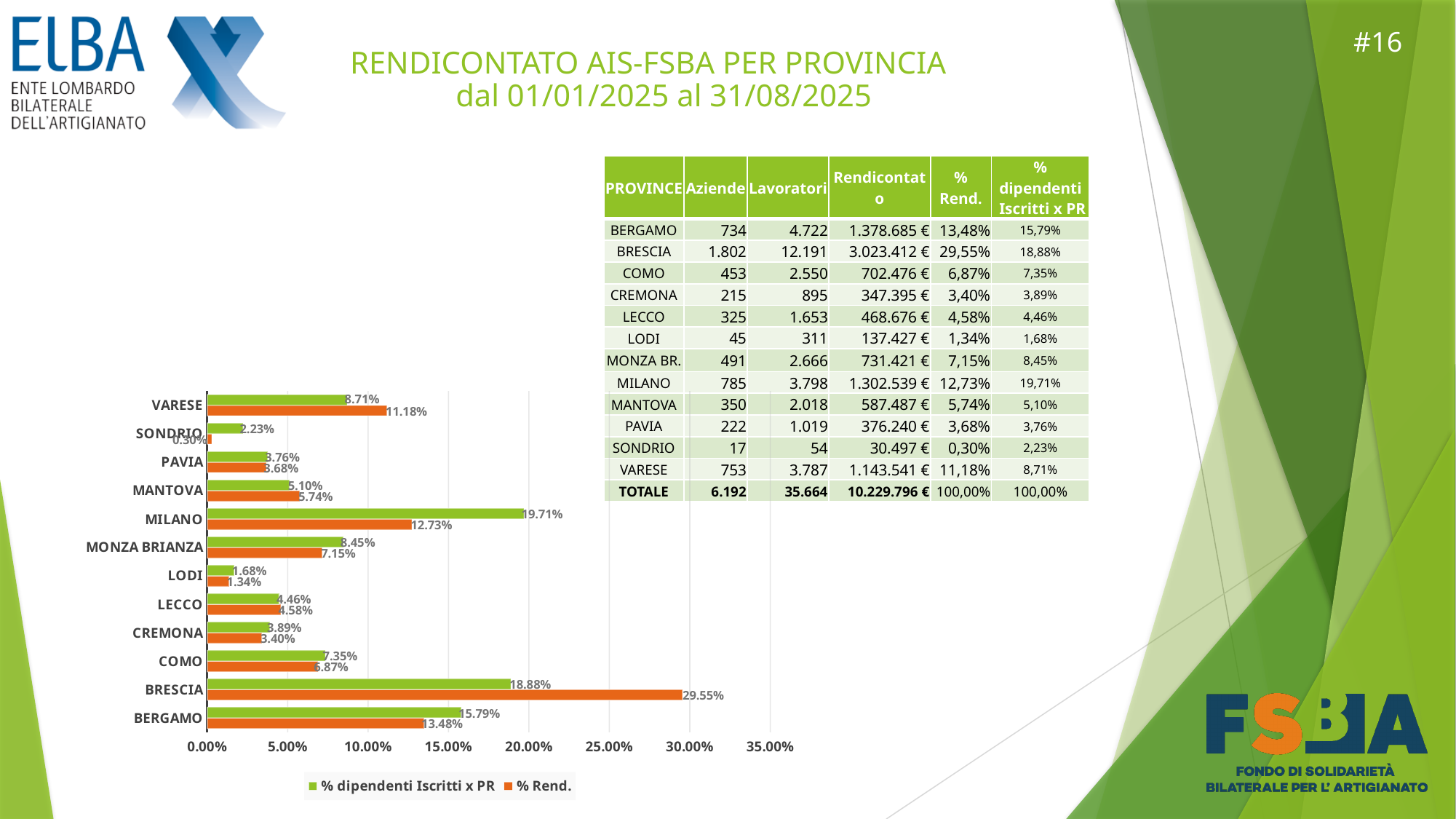
What is the difference between the % Rend. and the % dipendenti Iscritti x PR values for BRESCIA? 10.67% What is the % Rend. value for SONDRIO in the chart? 0.30% What is the % Rend. value for BRESCIA in the chart? 29.55% For MILANO, which is larger: % dipendenti Iscritti x PR or % Rend.? % dipendenti Iscritti x PR Which series is shown in orange in the chart? % Rend. Is the % Rend. value for BERGAMO greater or less than 15.00%? less Which province has the lowest % dipendenti Iscritti x PR value in the chart? LODI How many provinces are plotted on the chart? 12 What is the % dipendenti Iscritti x PR value for MILANO in the chart? 19.71% How many series does the chart legend list? 2 What kind of chart is shown on the slide? bar chart Which province has the highest % Rend. value in the chart? BRESCIA